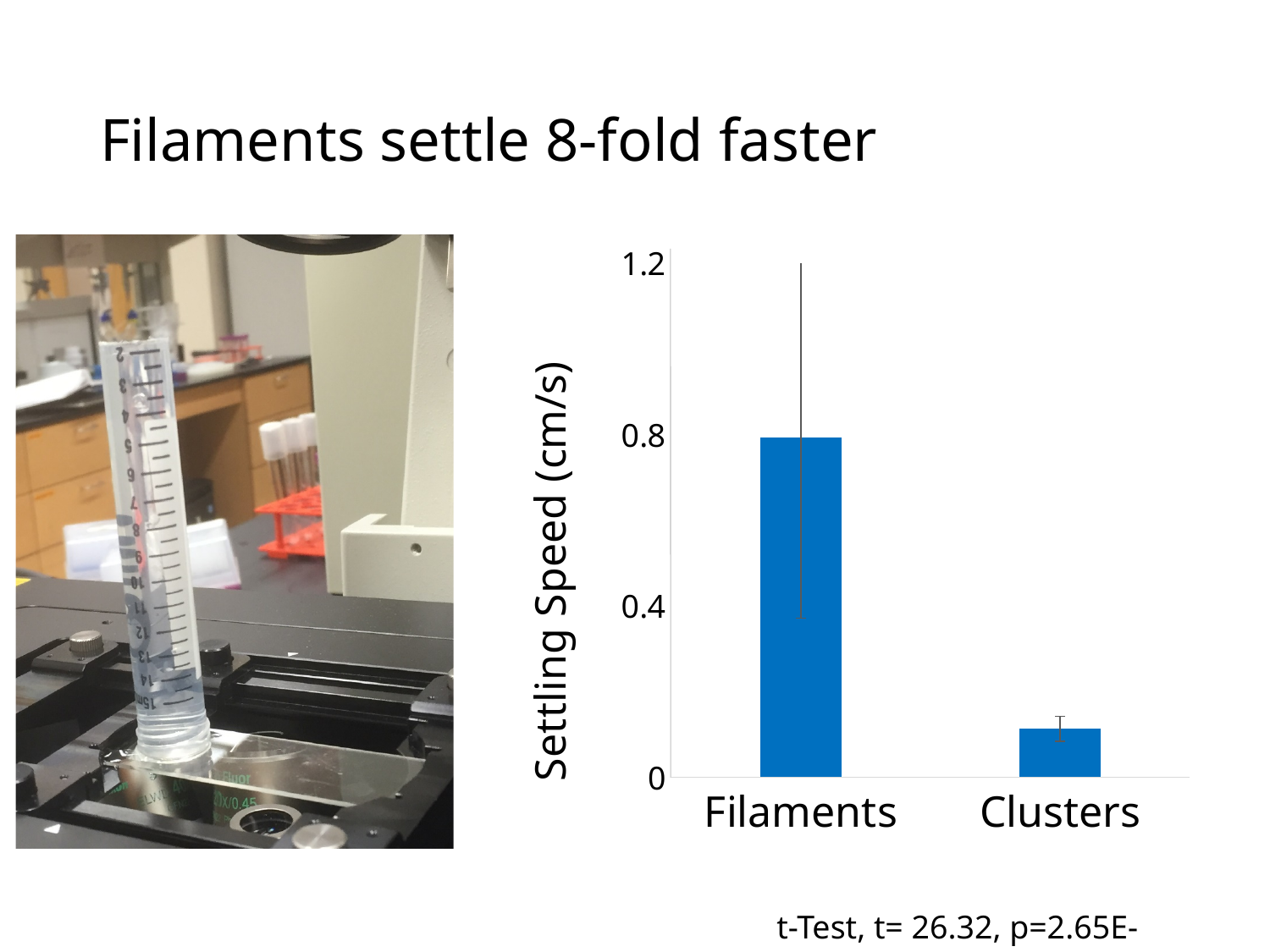
What kind of chart is shown on the slide? bar chart Is the value for Filaments greater or less than 1.2? less Is the value for Filaments greater or less than 0.4? greater What is the label of the vertical axis? Settling Speed (cm/s) Is the value for Clusters greater or less than 0.8? less What is the title of the slide? Filaments settle 8-fold faster How many categories are plotted on the chart? 2 Which category has the highest settling speed? Filaments Which has a larger settling speed, Filaments or Clusters? Filaments Which category has the lowest settling speed? Clusters